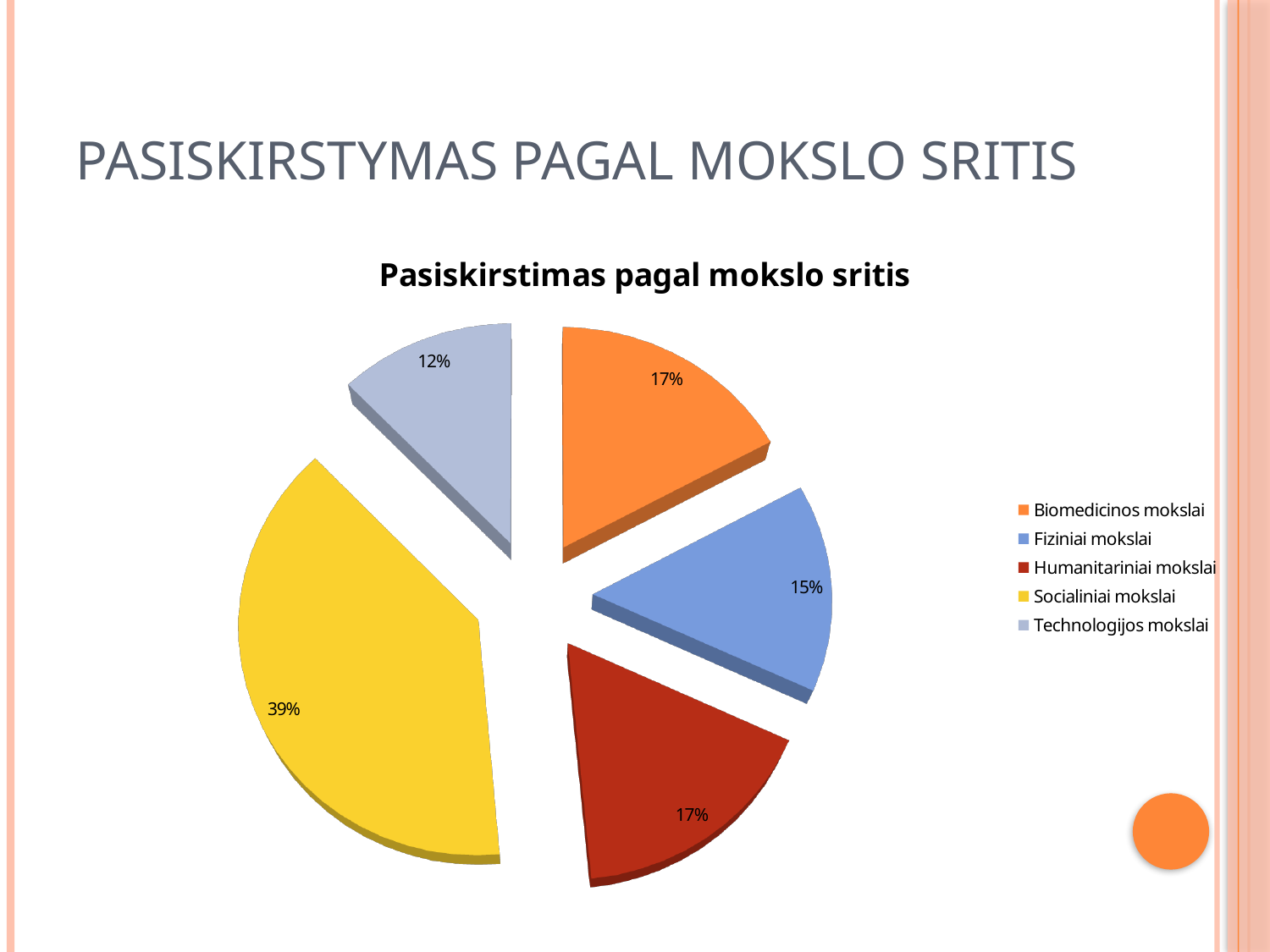
What share of the pie does Biomedicinos mokslai hold? 17% How many categories does the pie chart show? 5 What is the title of the chart? Pasiskirstimas pagal mokslo sritis What share of the pie does Socialiniai mokslai hold? 39% What share of the pie does Fiziniai mokslai hold? 15% What is the difference in percentage points between Socialiniai mokslai and Technologijos mokslai? 27 Which category has the largest slice of the pie? Socialiniai mokslai What kind of chart is shown on the slide? Pie chart Which category is shown in yellow in the legend? Socialiniai mokslai Which category has the smallest slice of the pie? Technologijos mokslai Which is larger, the share for Fiziniai mokslai or the share for Humanitariniai mokslai? Humanitariniai mokslai